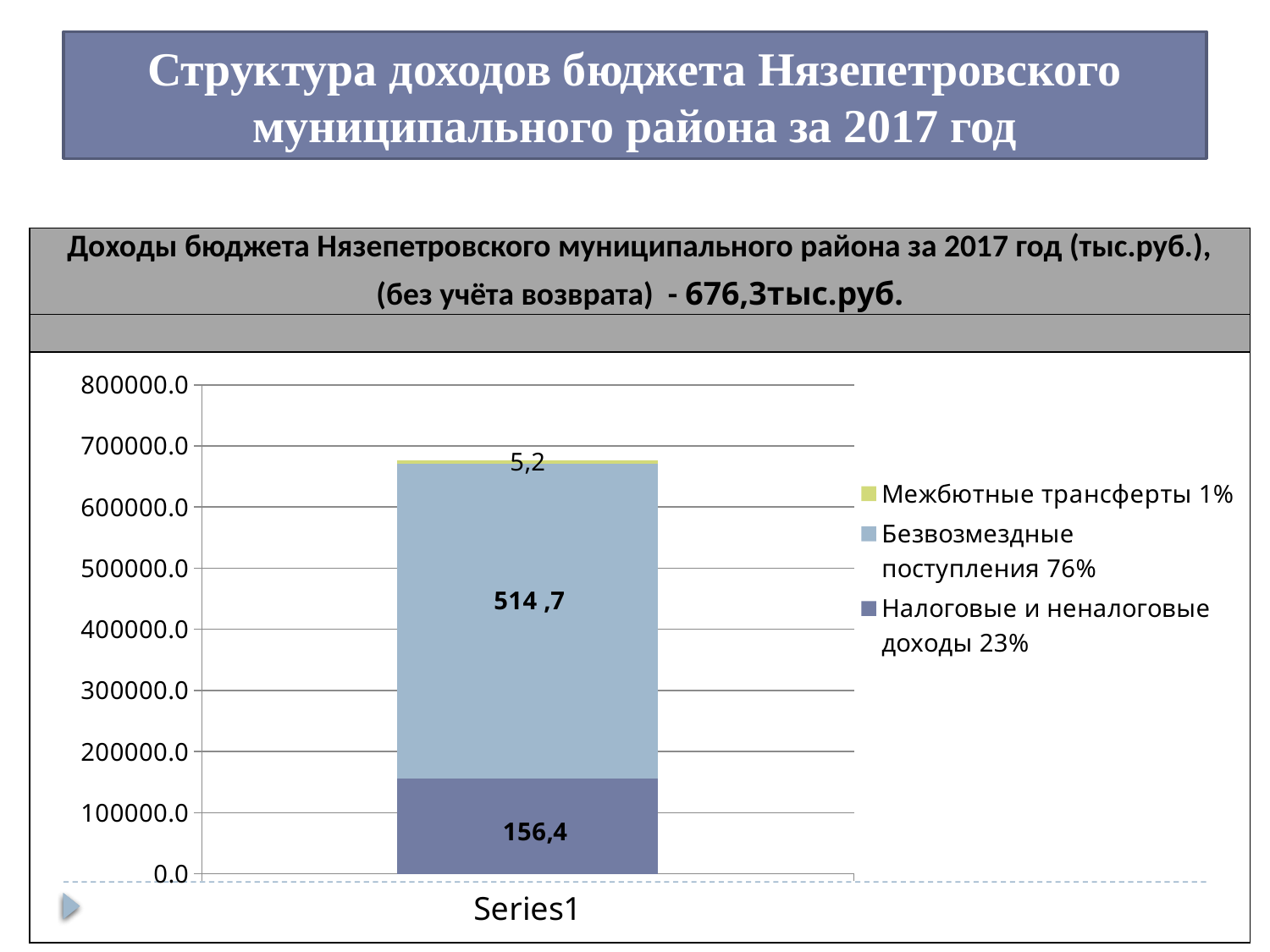
What kind of chart is shown on the slide? bar chart Which series has the largest segment in the stacked bar? Безвозмездные поступления How many series does the legend list? 3 Which series has the smallest segment in the stacked bar? Межбютные трансферты What is the value labelled for Безвозмездные поступления? 514,7 Is the top of the stacked bar for Series1 greater or less than 600000.0? greater What percentage share does the legend give for Безвозмездные поступления? 76% What is the difference between the values for Безвозмездные поступления and Налоговые и неналоговые доходы? 358,3 Which is larger, the value for Налоговые и неналоговые доходы or the value for Межбютные трансферты? Налоговые и неналоговые доходы What is the value labelled for Межбютные трансферты? 5,2 How many categories are plotted on the x axis? 1 What is the value labelled for Налоговые и неналоговые доходы? 156,4